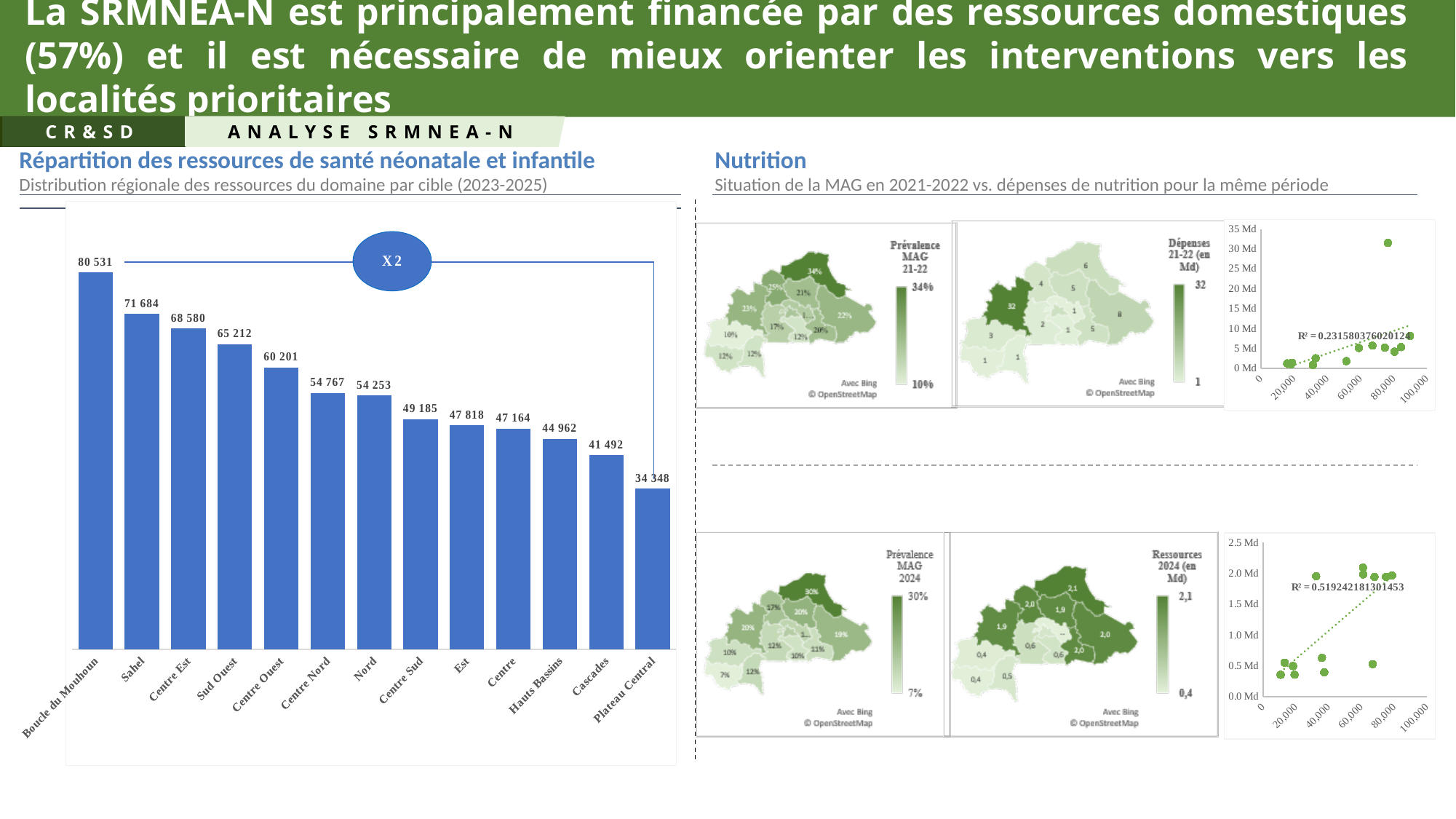
On the bar chart 'Distribution régionale des ressources du domaine par cible (2023-2025)', what is the value for Centre Ouest? 60 201 On the bar chart 'Distribution régionale des ressources du domaine par cible (2023-2025)', what is the value for Hauts Bassins? 44 962 On the bar chart 'Distribution régionale des ressources du domaine par cible (2023-2025)', which is larger, Sud Ouest or Cascades? Sud Ouest On the bar chart 'Distribution régionale des ressources du domaine par cible (2023-2025)', do the values rise or fall from left to right? fall On the bar chart 'Distribution régionale des ressources du domaine par cible (2023-2025)', how many regions are shown? 13 On the bar chart 'Distribution régionale des ressources du domaine par cible (2023-2025)', what is the value for Boucle du Mouhoun? 80 531 On the bar chart 'Distribution régionale des ressources du domaine par cible (2023-2025)', what is the difference between Sahel and Centre Est? 3 104 What kind of chart is 'Distribution régionale des ressources du domaine par cible (2023-2025)'? bar chart On the bar chart 'Distribution régionale des ressources du domaine par cible (2023-2025)', which region has the highest value? Boucle du Mouhoun What R² value is shown on the top scatter plot in the Nutrition section (Dépenses 21-22)? 0.231580376020124 On the bar chart 'Distribution régionale des ressources du domaine par cible (2023-2025)', what is the difference between Boucle du Mouhoun and Plateau Central? 46 183 On the bar chart 'Distribution régionale des ressources du domaine par cible (2023-2025)', which region has the lowest value? Plateau Central